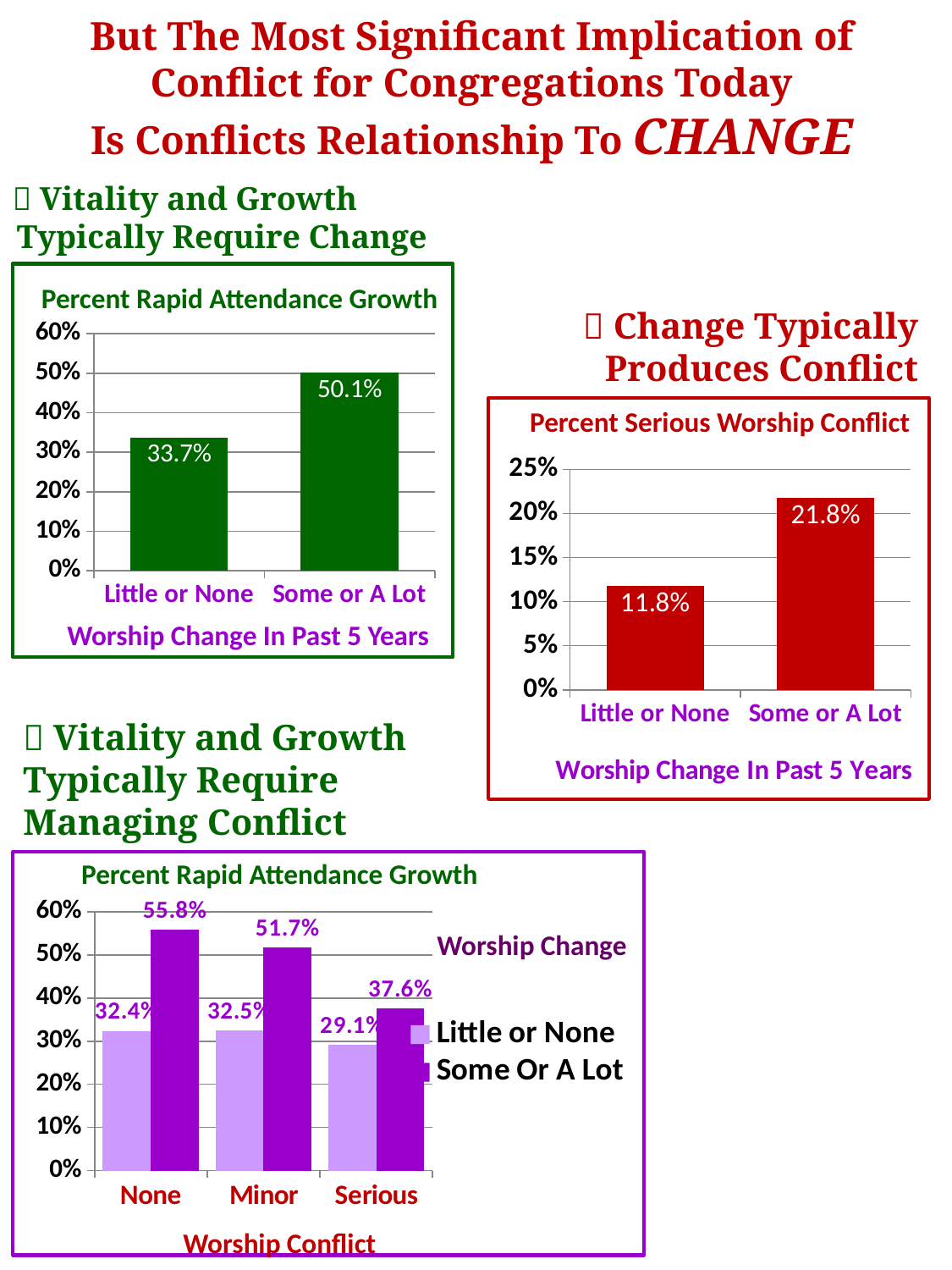
In the bottom chart titled "Percent Rapid Attendance Growth", how many categories are shown on the x axis? 3 In the bottom chart titled "Percent Rapid Attendance Growth", do the "Some Or A Lot" values rise or fall from "None" to "Serious"? Fall In the chart titled "Percent Serious Worship Conflict", which category has the lowest value? Little or None In the top-left chart titled "Percent Rapid Attendance Growth", what is the value for "Some or A Lot"? 50.1% In the chart titled "Percent Serious Worship Conflict", what is the value for "Some or A Lot"? 21.8% In the chart titled "Percent Serious Worship Conflict", what is the difference between the two bars? 10% In the bottom chart titled "Percent Rapid Attendance Growth", what is the "Little or None" value for "Serious" worship conflict? 29.1% In the chart titled "Percent Serious Worship Conflict", what kind of chart is shown? Bar chart In the top-left chart titled "Percent Rapid Attendance Growth", what is the value for "Little or None"? 33.7% In the bottom chart titled "Percent Rapid Attendance Growth", how many series does the legend list? 2 In the top-left chart titled "Percent Rapid Attendance Growth", what is the difference between the "Some or A Lot" and "Little or None" values? 16.4% In the bottom chart titled "Percent Rapid Attendance Growth", what is the "Some Or A Lot" value for "None" worship conflict? 55.8%